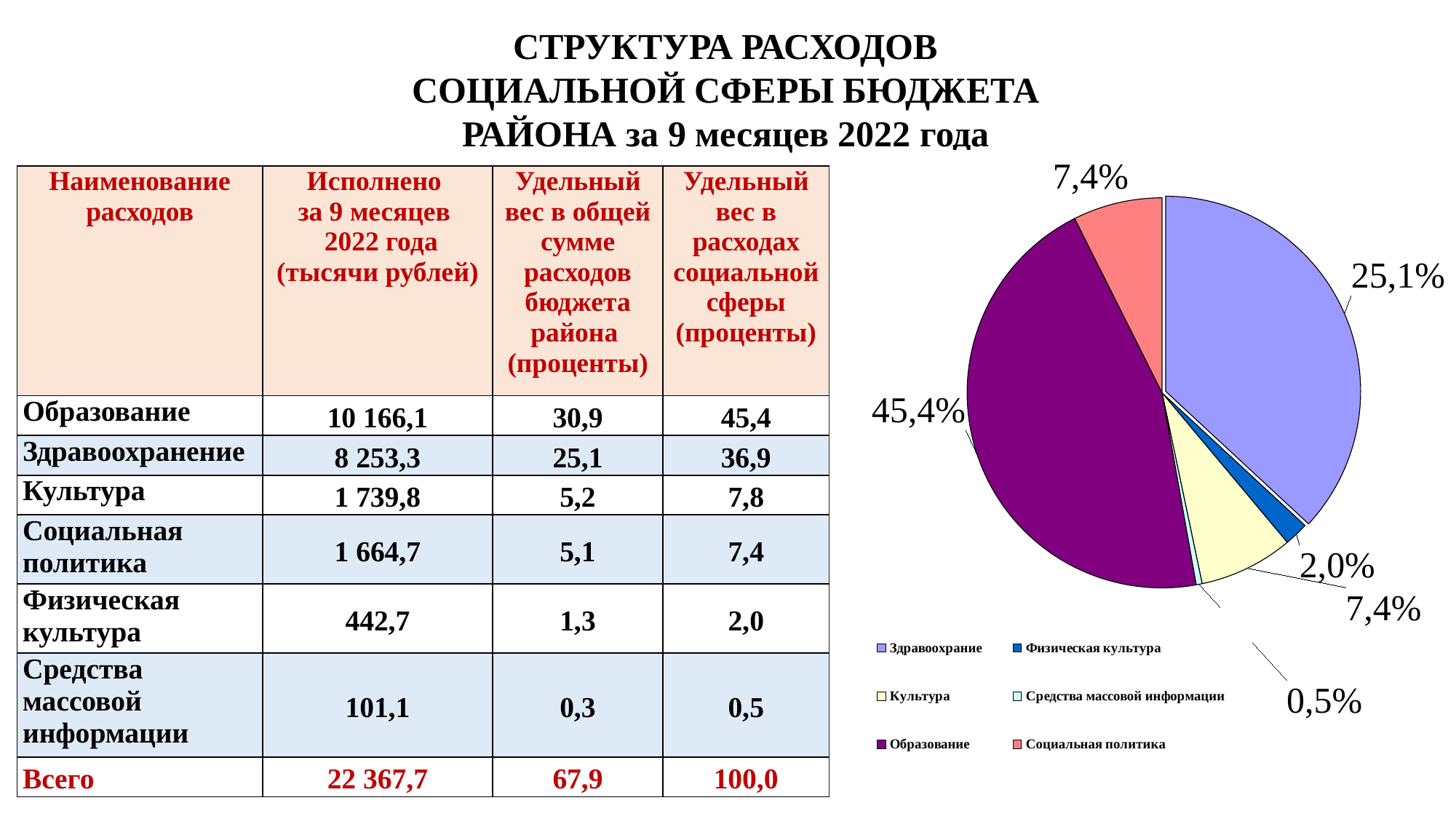
What share of the pie chart does Физическая культура have? 2,0% What share of the pie chart does Здравоохранение have? 25,1% In the pie chart, by how many percentage points does Образование exceed Здравоохранение? 20,3 What kind of chart is shown on the right side of the slide? Pie chart What share of the pie chart does Социальная политика have? 7,4% How many categories does the pie chart's legend list? 6 In the pie chart, which is larger: Здравоохранение or Социальная политика? Здравоохранение What share of the pie chart does Образование have? 45,4% Which category has the largest slice in the pie chart? Образование What share of the pie chart does Средства массовой информации have? 0,5% What colour is the Образование slice in the pie chart? Purple Which category has the smallest slice in the pie chart? Средства массовой информации